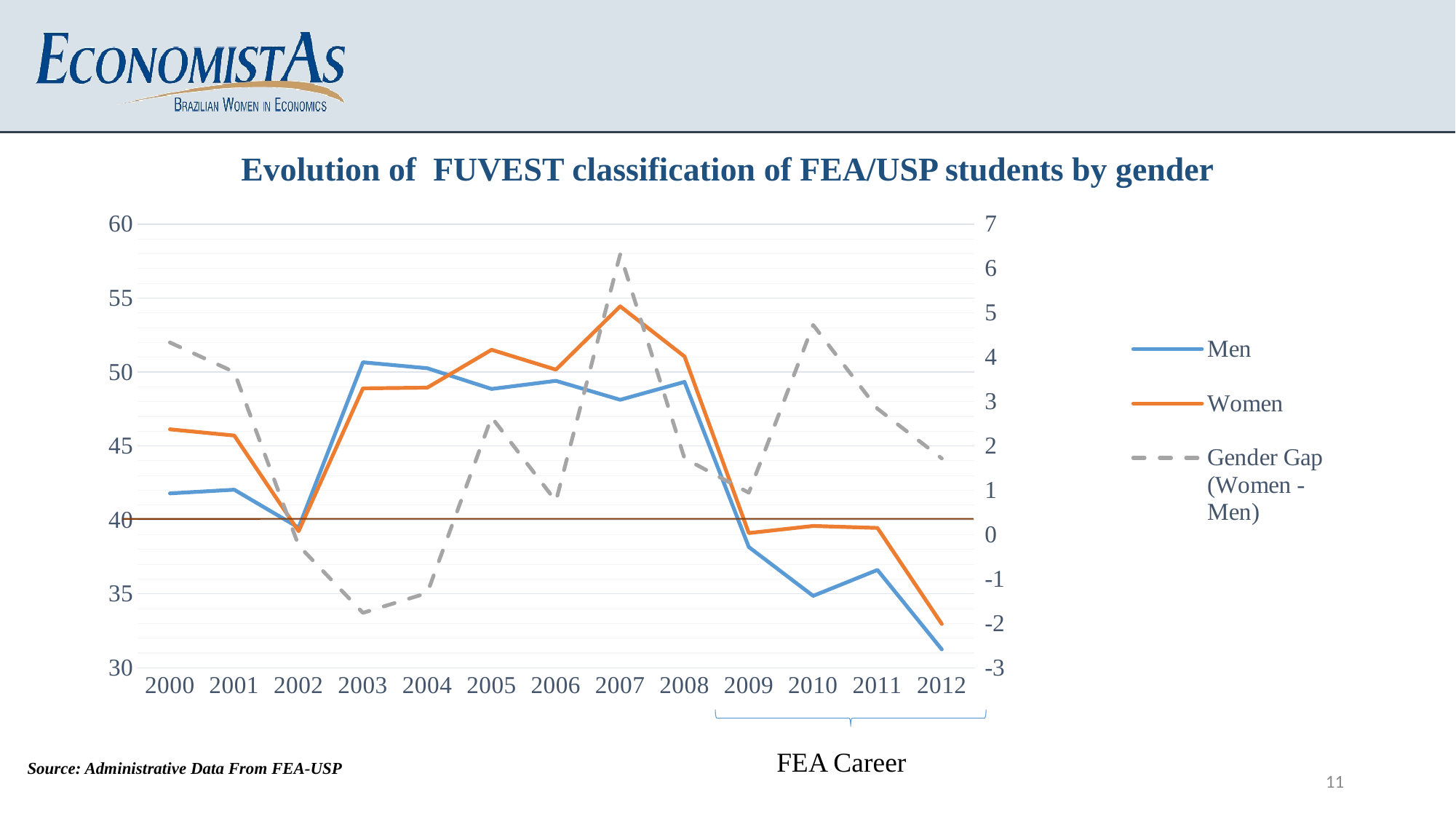
In which year does the Men series reach its lowest value? 2012 How many years are plotted along the x axis? 13 In which year is the Gender Gap (Women - Men) series at its highest? 2007 What is the title of the chart? Evolution of FUVEST classification of FEA/USP students by gender In which year is the Gender Gap (Women - Men) series at its lowest? 2003 In which year does the Women series reach its highest value? 2007 In 2000, which series has the higher value, Men or Women? Women Is the value for Women in 2007 greater or less than 50? greater What kind of chart is shown on the slide? line chart How many series does the legend list? 3 In 2003, which series has the higher value, Men or Women? Men Is the value for Men in 2012 greater or less than 35? less